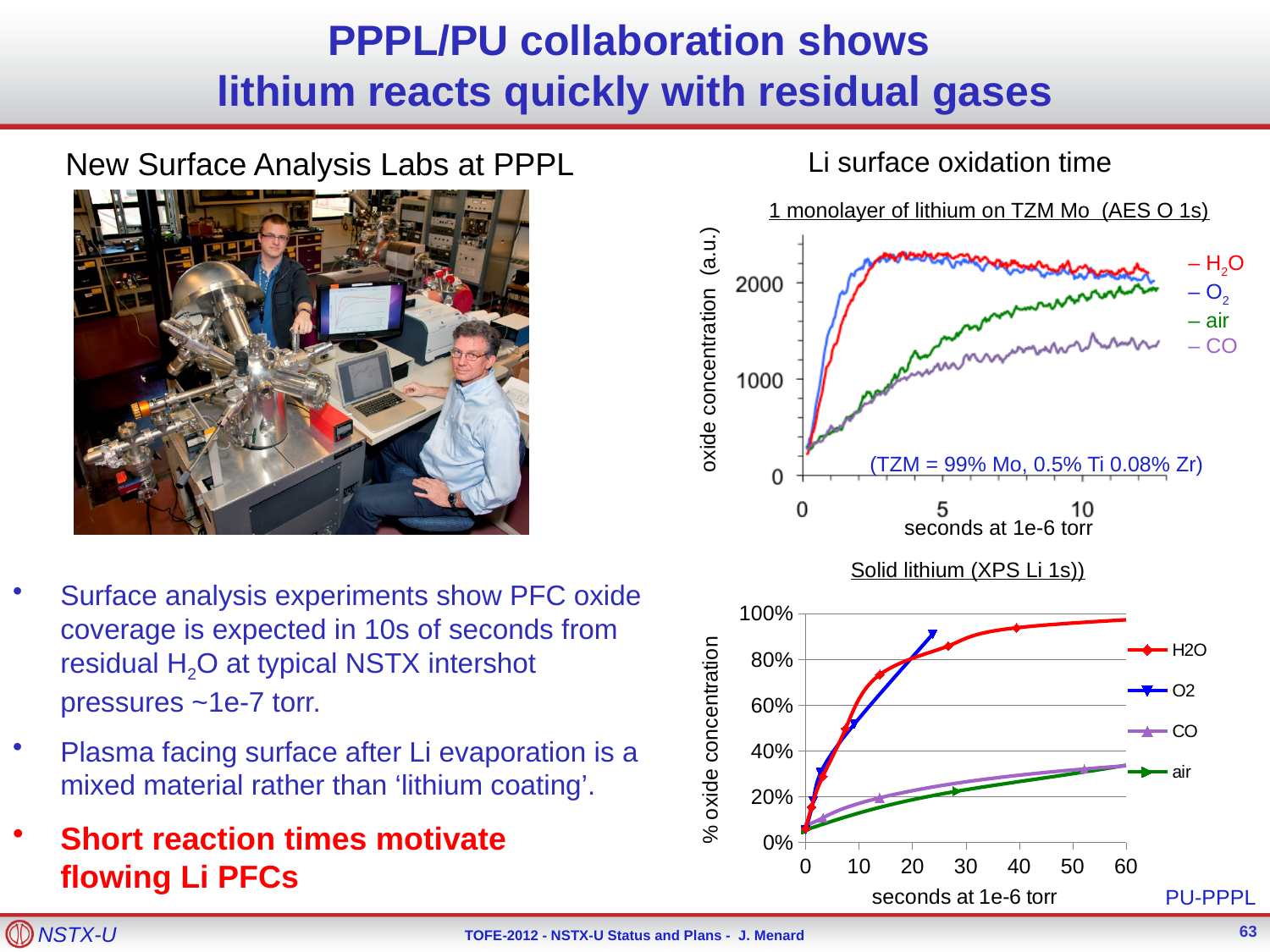
In the top chart '1 monolayer of lithium on TZM Mo', is the oxide concentration for CO at 10 seconds greater or less than 1000? greater In the bottom chart 'Solid lithium (XPS Li 1s))', which series has the highest % oxide concentration at 60 seconds? H2O In the bottom chart 'Solid lithium (XPS Li 1s))', how many series does the legend list? 4 What kind of chart is the bottom chart titled 'Solid lithium (XPS Li 1s))'? line chart In the bottom chart 'Solid lithium (XPS Li 1s))', is the % oxide concentration for H2O at 40 seconds greater or less than 80%? greater What kind of chart is the top chart titled '1 monolayer of lithium on TZM Mo (AES O 1s)'? line chart In the bottom chart 'Solid lithium (XPS Li 1s))', is the % oxide concentration for CO at 60 seconds greater or less than 40%? less In the top chart '1 monolayer of lithium on TZM Mo', which gas has the lowest oxide concentration at 10 seconds? CO In the bottom chart 'Solid lithium (XPS Li 1s))', at 10 seconds, which has the higher % oxide concentration, H2O or CO? H2O In the top chart '1 monolayer of lithium on TZM Mo', how many gas series are listed in the legend? 4 In the bottom chart 'Solid lithium (XPS Li 1s))', what is the label of the x axis? seconds at 1e-6 torr